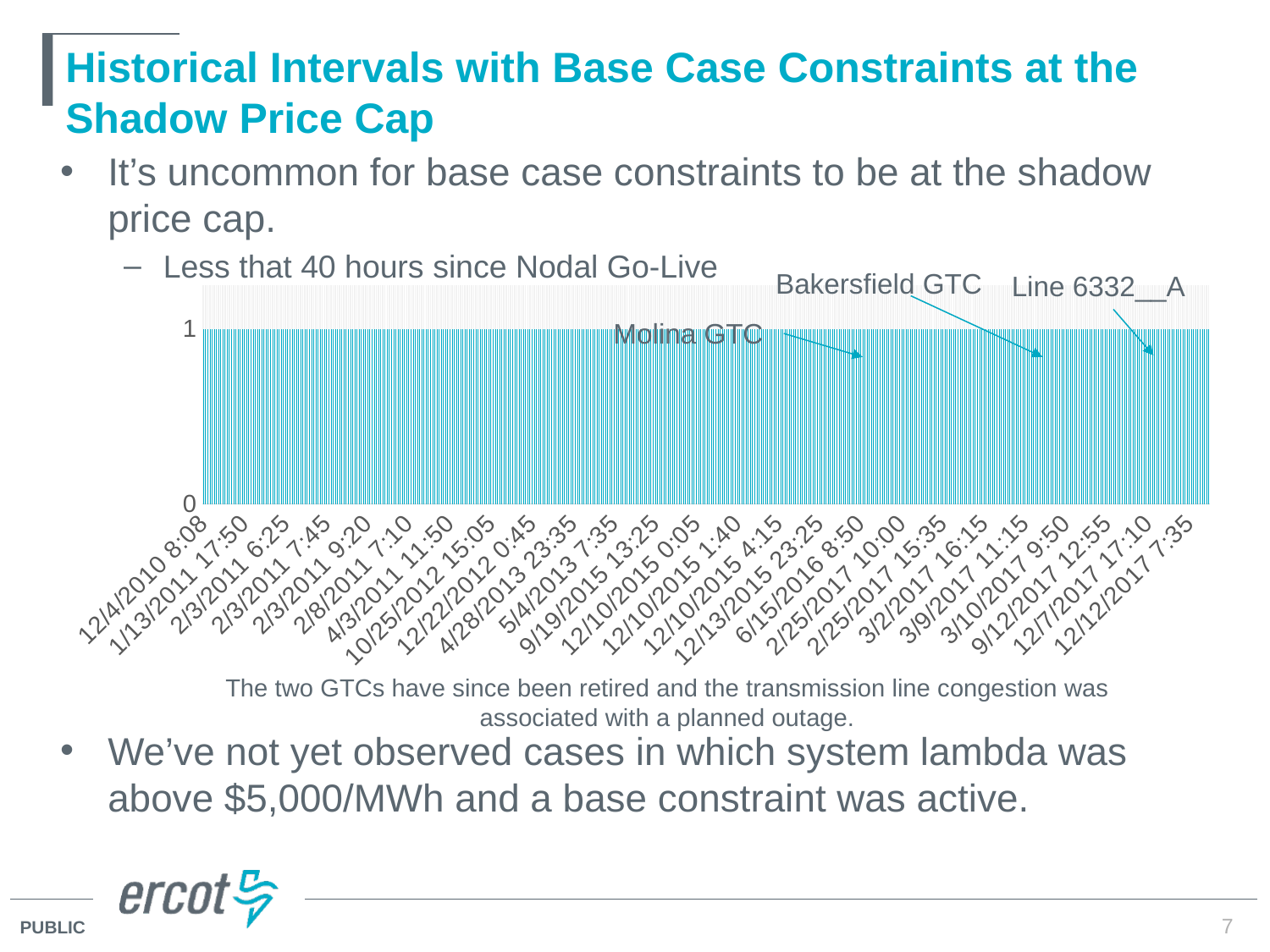
Which three constraints are labelled with arrows on the chart? Molina GTC, Bakersfield GTC, Line 6332__A Do the plotted values rise, fall, or stay flat across the x axis? stay flat What kind of chart is shown on the slide? bar chart What is the highest tick value shown on the y axis? 1 What is the value plotted for 12/12/2017 7:35? 1 Is the value for 5/4/2013 7:35 greater or less than 0? greater What is the value plotted for 6/15/2016 8:50? 1 What is the value plotted for 12/4/2010 8:08? 1